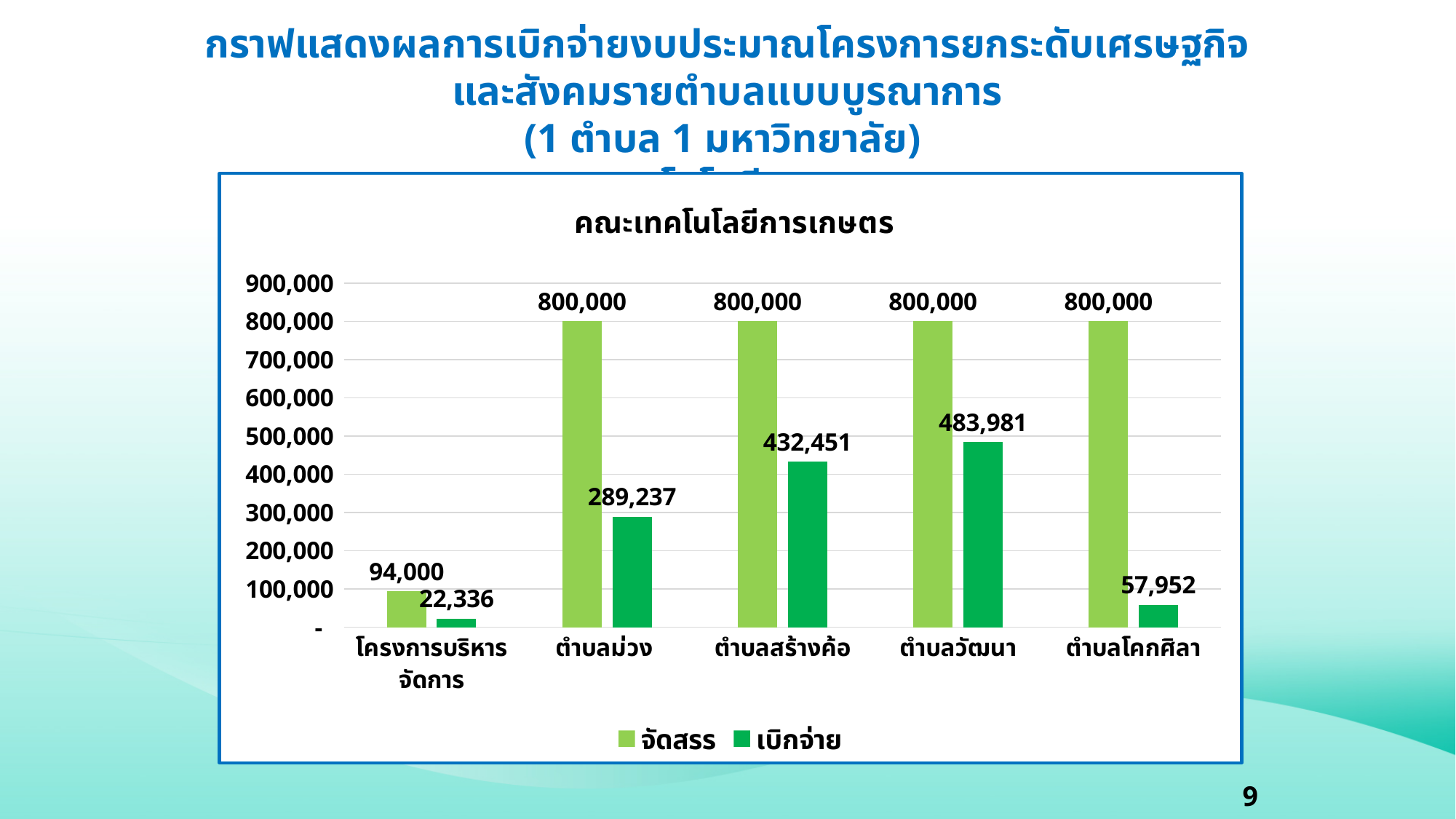
What is the difference between the เบิกจ่าย values for ตำบลวัฒนา and ตำบลโคกศิลา? 426,029 Which is larger, the เบิกจ่าย value for ตำบลสร้างค้อ or for ตำบลม่วง? ตำบลสร้างค้อ How many categories are shown on the x axis? 5 What is the title of the chart? คณะเทคโนโลยีการเกษตร Which category has the highest เบิกจ่าย value? ตำบลวัฒนา Which category has the lowest เบิกจ่าย value? โครงการบริหารจัดการ What is the เบิกจ่าย value for ตำบลโคกศิลา? 57,952 What is the จัดสรร value for โครงการบริหารจัดการ? 94,000 How many series does the legend list? 2 What is the difference between the จัดสรร and เบิกจ่าย values for ตำบลม่วง? 510,763 What is the เบิกจ่าย value for ตำบลสร้างค้อ? 432,451 What type of chart is shown on the slide? bar chart